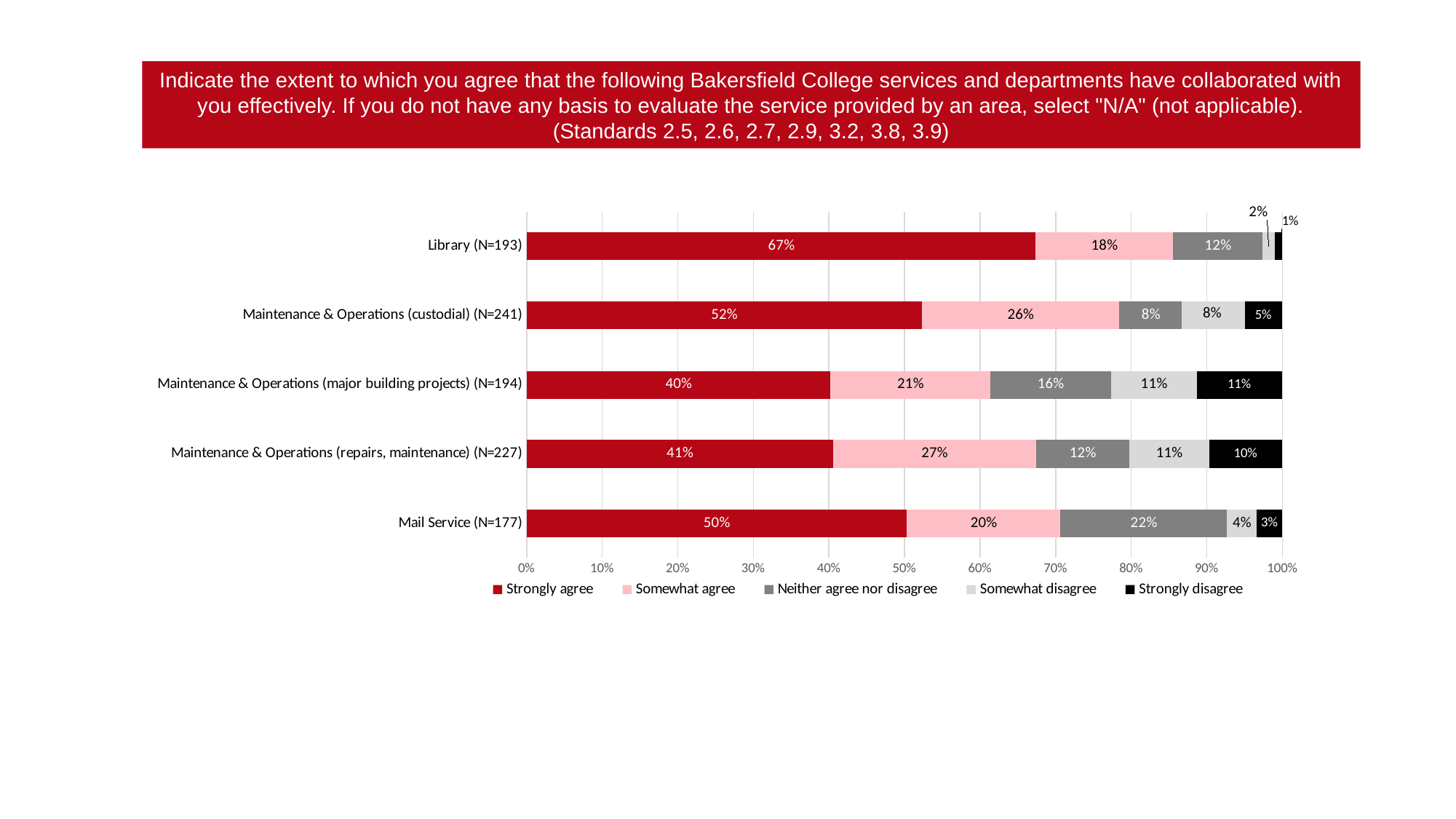
What is the Neither agree nor disagree value for Mail Service (N=177)? 22% What is the difference between the Strongly agree values for Library (N=193) and Mail Service (N=177)? 17% What is the Somewhat agree value for Maintenance & Operations (repairs, maintenance) (N=227)? 27% How many series does the legend list? 5 Which legend entry is shown in black? Strongly disagree What is the Strongly disagree value for Maintenance & Operations (major building projects) (N=194)? 11% Which category has the lowest Strongly agree percentage? Maintenance & Operations (major building projects) (N=194) What percentage of respondents strongly agree for Library (N=193)? 67% How many categories (services/departments) are shown in the chart? 5 Which category has the highest Strongly agree percentage? Library (N=193) What kind of chart is shown on the slide? Stacked bar chart Which has a larger Somewhat agree value: Maintenance & Operations (custodial) (N=241) or Mail Service (N=177)? Maintenance & Operations (custodial) (N=241)